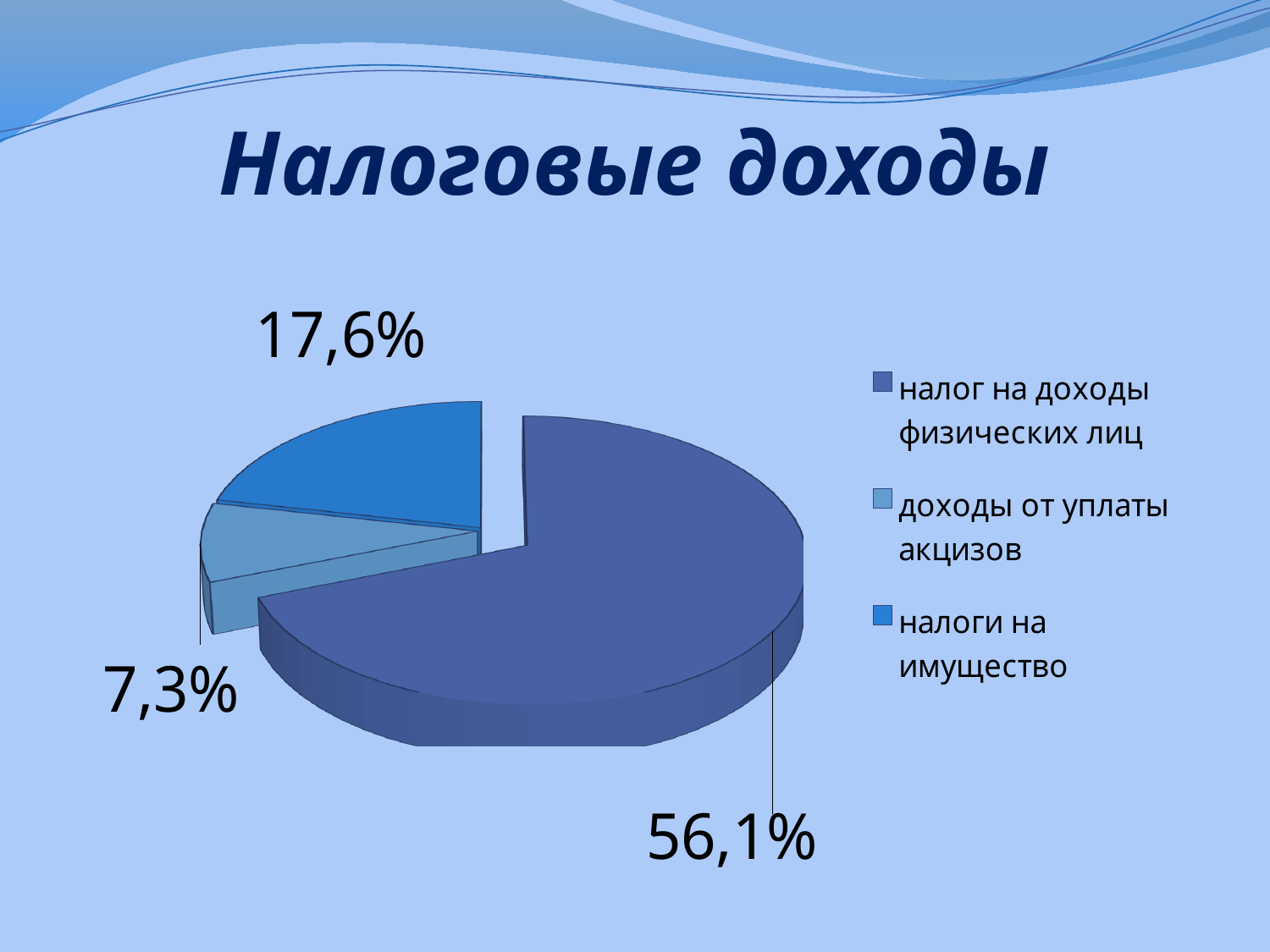
How many slices does the pie chart have? 3 Which is larger: the slice for налоги на имущество or the slice for доходы от уплаты акцизов? налоги на имущество What share of the pie is labelled for налог на доходы физических лиц? 56,1% Which category has the largest slice of the pie? налог на доходы физических лиц What is the difference in percentage points between the slice for налоги на имущество and the slice for доходы от уплаты акцизов? 10,3 What kind of chart is shown on the slide? pie chart Which category has the smallest slice of the pie? доходы от уплаты акцизов What share of the pie is labelled for доходы от уплаты акцизов? 7,3% How many entries does the legend list? 3 What is the difference in percentage points between the slice for налог на доходы физических лиц and the slice for налоги на имущество? 38,5 What share of the pie is labelled for налоги на имущество? 17,6% What is the title of the chart? Налоговые доходы